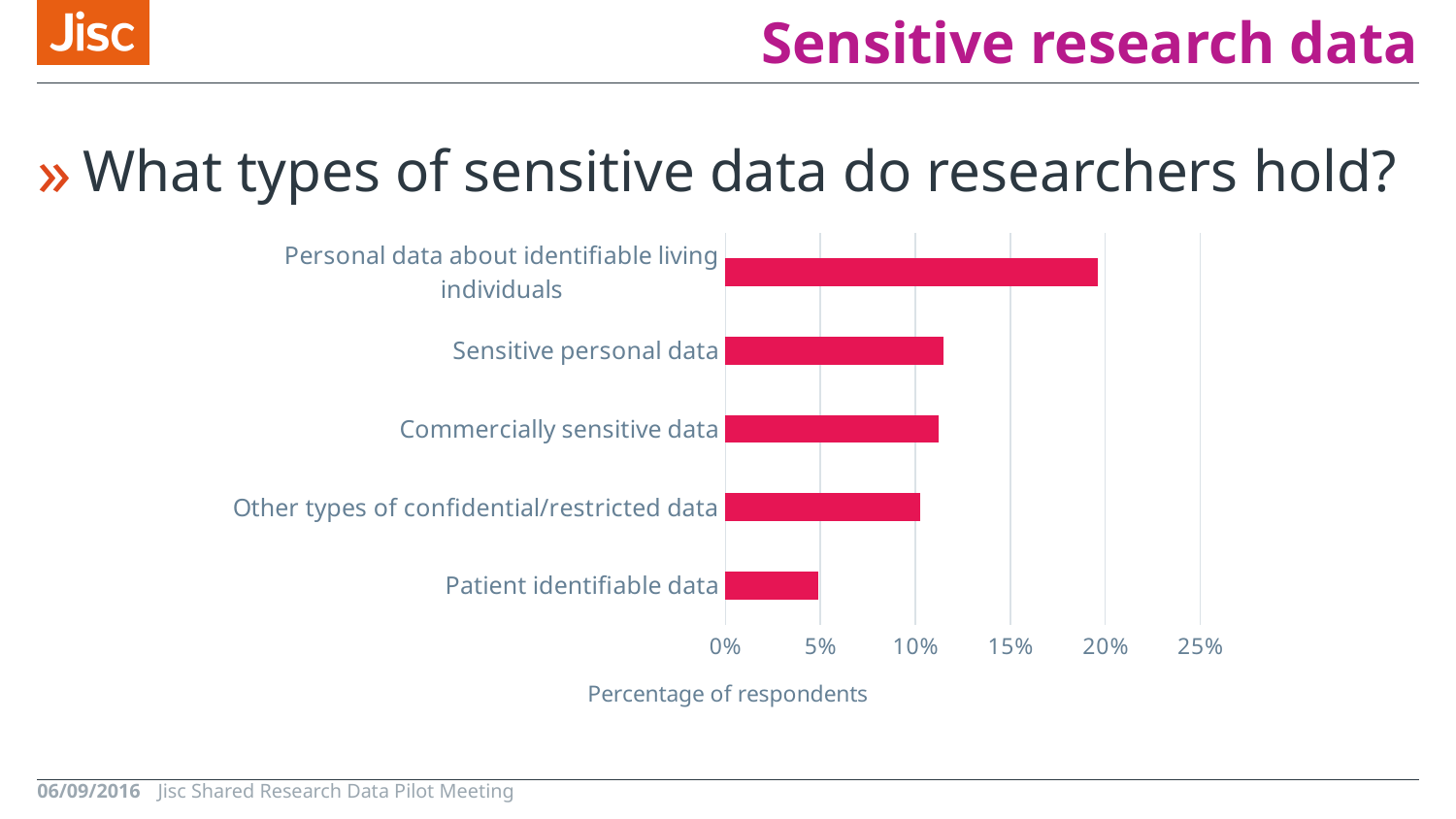
How many categories of sensitive data are plotted in the chart? 5 Which is larger: the value for Sensitive personal data or the value for Patient identifiable data? Sensitive personal data Is the value for Other types of confidential/restricted data greater or less than 15%? less Is the value for Personal data about identifiable living individuals greater or less than 15%? greater Is the value for Sensitive personal data greater or less than 10%? greater Which category has the lowest percentage of respondents? Patient identifiable data Which category has the highest percentage of respondents? Personal data about identifiable living individuals Which is larger: the value for Personal data about identifiable living individuals or the value for Patient identifiable data? Personal data about identifiable living individuals What kind of chart is shown on the slide? bar chart What is the label of the horizontal axis of the chart? Percentage of respondents